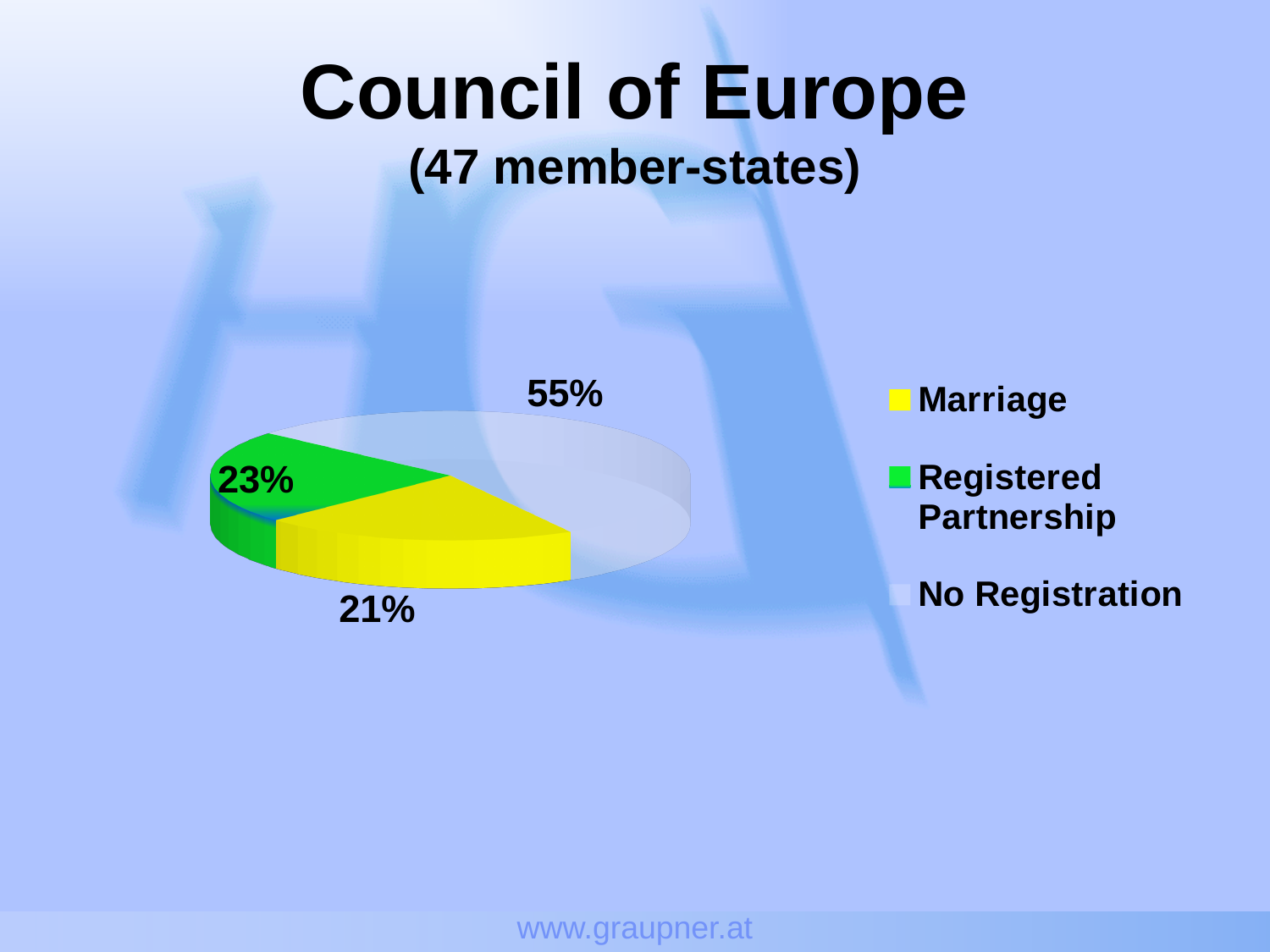
What kind of chart is shown on the slide? pie chart What percentage of the pie is labelled for Marriage? 21% Which is larger, the Registered Partnership slice or the Marriage slice? Registered Partnership Which category has the smallest slice of the pie? Marriage Which category has the largest slice of the pie? No Registration What is the difference in percentage points between the No Registration slice and the Registered Partnership slice? 32 What percentage of the pie is labelled for No Registration? 55% What colour is the Marriage slice in the pie chart? yellow What percentage of the pie is labelled for Registered Partnership? 23% How many slices does the pie chart have? 3 How many entries does the legend list? 3 What is the title of the slide containing the pie chart? Council of Europe (47 member-states)